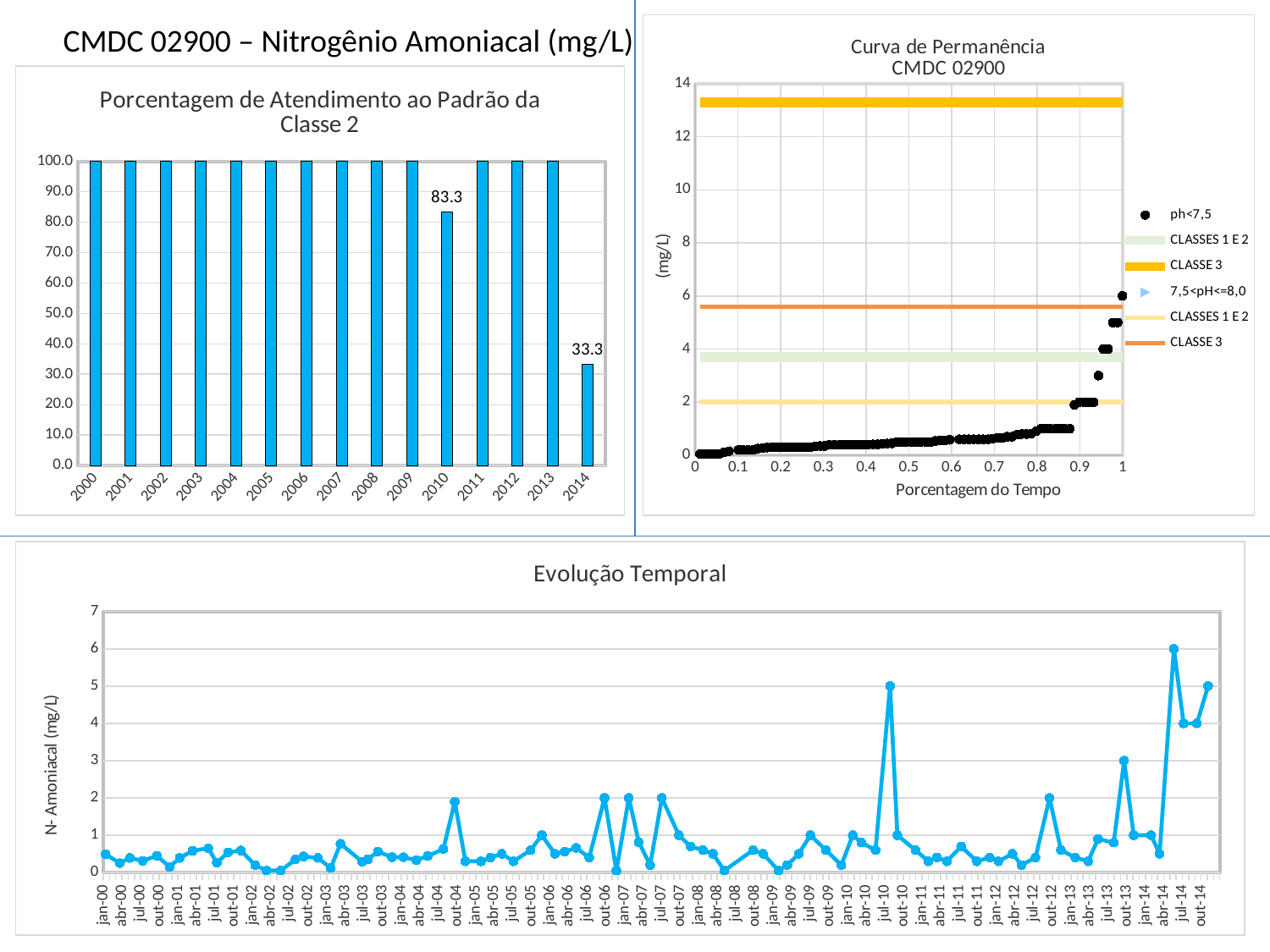
In the chart 'Porcentagem de Atendimento ao Padrão da Classe 2', what is the value for 2014? 33.3 How many entries does the legend of the chart 'Curva de Permanência CMDC 02900' list? 6 In the chart 'Porcentagem de Atendimento ao Padrão da Classe 2', what is the value for 2010? 83.3 What is the x-axis title of the chart 'Curva de Permanência CMDC 02900'? Porcentagem do Tempo What kind of chart is 'Porcentagem de Atendimento ao Padrão da Classe 2'? bar chart In the chart 'Porcentagem de Atendimento ao Padrão da Classe 2', what is the value for 2000? 100.0 In the chart 'Porcentagem de Atendimento ao Padrão da Classe 2', what is the difference between the values for 2010 and 2014? 50.0 What kind of chart is 'Evolução Temporal'? line chart How many years (bars) are shown in the chart 'Porcentagem de Atendimento ao Padrão da Classe 2'? 15 In the chart 'Porcentagem de Atendimento ao Padrão da Classe 2', which is larger, the value for 2010 or the value for 2014? 2010 In the chart 'Evolução Temporal', is the value for jul-10 greater or less than 4? greater In the chart 'Porcentagem de Atendimento ao Padrão da Classe 2', which year has the lowest value? 2014